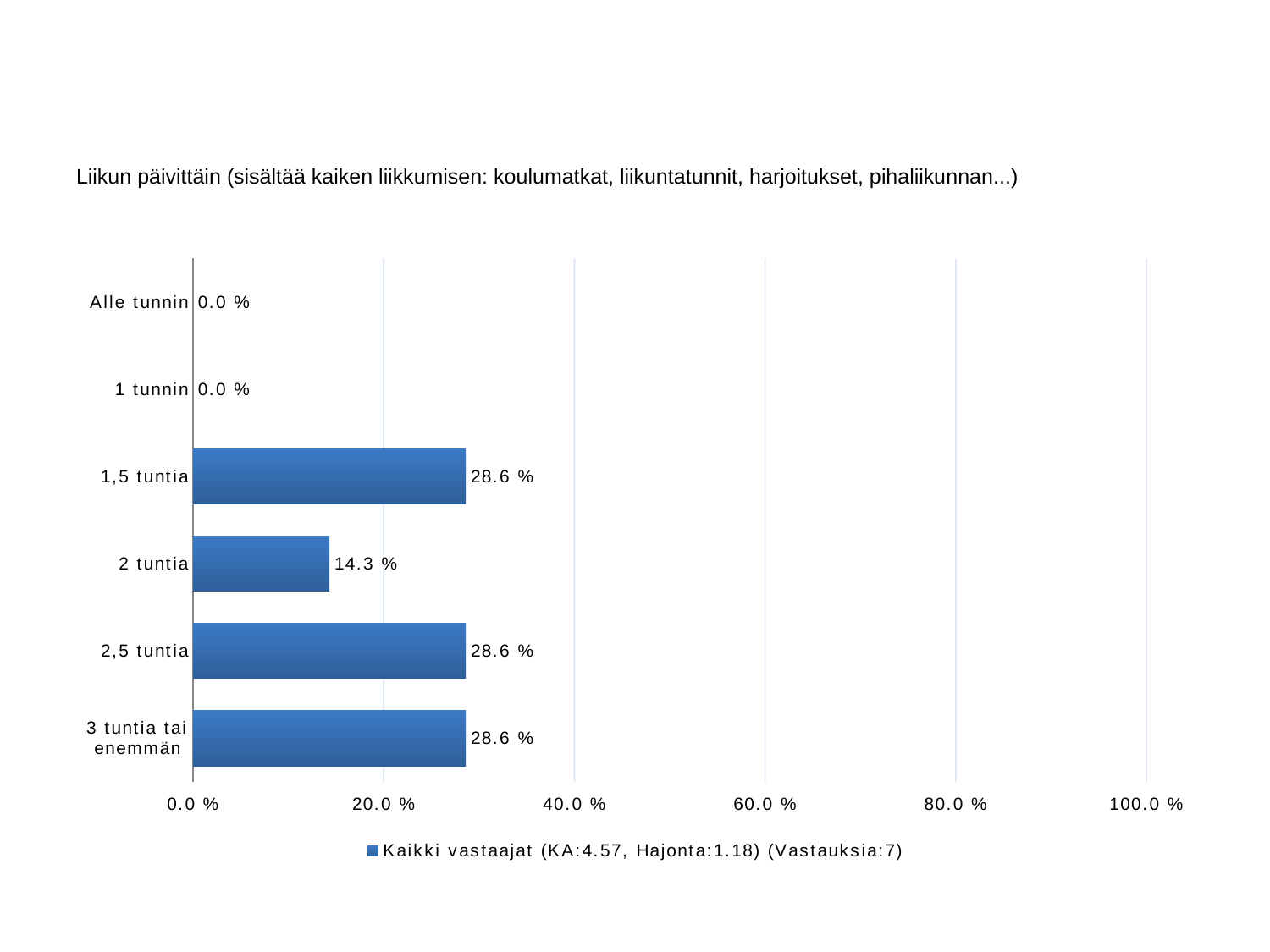
How many series does the legend list? 1 What is the value for "3 tuntia tai enemmän"? 28.6 % Is the value for "2 tuntia" greater or less than 20.0 %? less What is the difference between the values for "2,5 tuntia" and "2 tuntia"? 14.3 % What kind of chart is shown on the slide? bar chart What is the value for "2 tuntia"? 14.3 % What is the value for "1,5 tuntia"? 28.6 % How many categories are shown on the chart? 6 Which has a larger value, "1,5 tuntia" or "2 tuntia"? 1,5 tuntia What is the value for "1 tunnin"? 0.0 % How many responses (Vastauksia) does the legend entry report? 7 What is the value for "Alle tunnin"? 0.0 %